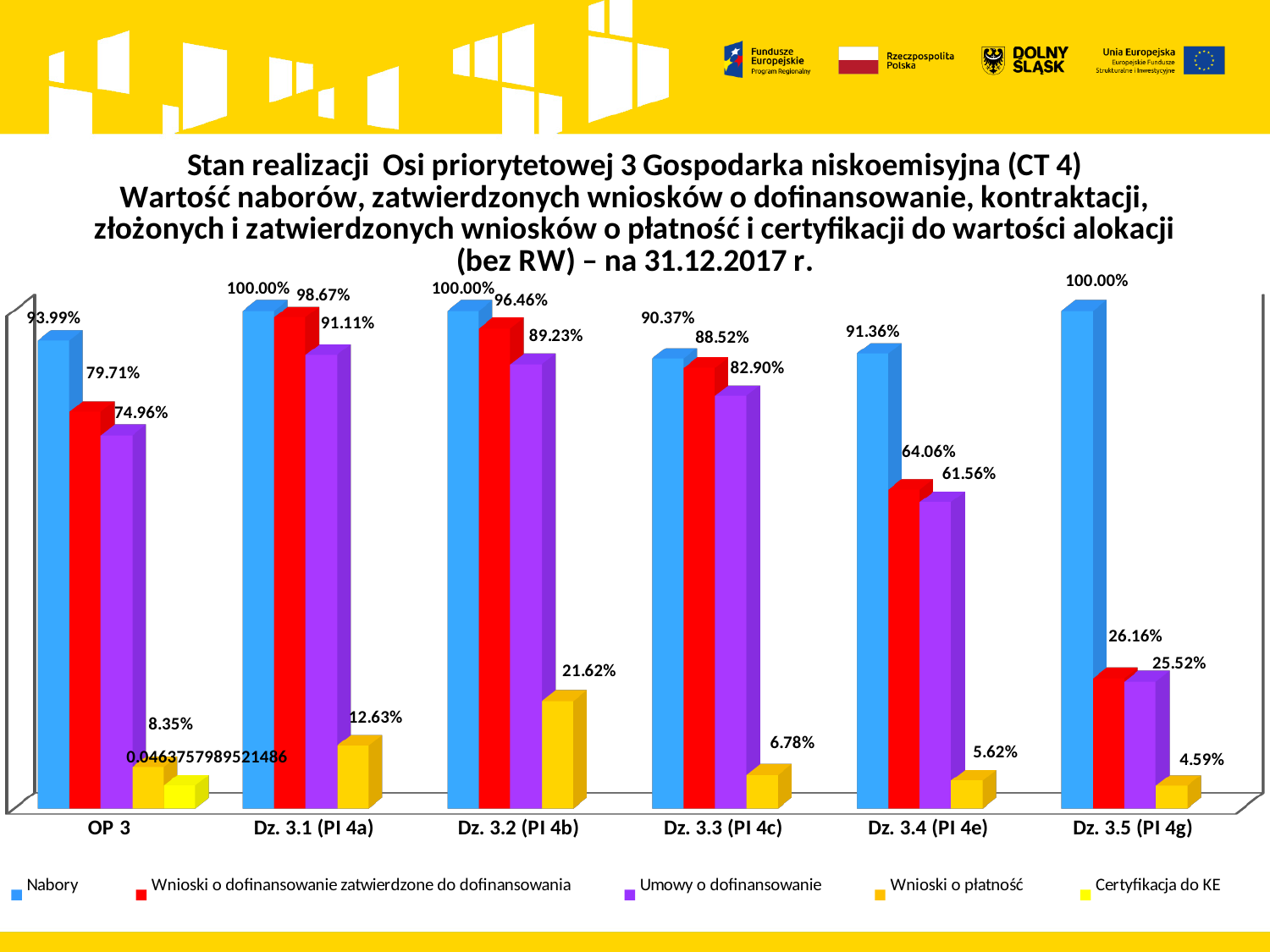
How many categories are shown on the x axis? 6 Which has a higher value for Umowy o dofinansowanie, Dz. 3.1 (PI 4a) or Dz. 3.2 (PI 4b)? Dz. 3.1 (PI 4a) What is the value of Wnioski o płatność for Dz. 3.2 (PI 4b)? 21.62% What is the value of Wnioski o dofinansowanie zatwierdzone do dofinansowania for Dz. 3.5 (PI 4g)? 26.16% What kind of chart is shown on the slide? Bar chart What is the difference between Nabory and Umowy o dofinansowanie for Dz. 3.4 (PI 4e)? 29.80 percentage points Which category has the highest value for Wnioski o płatność? Dz. 3.2 (PI 4b) How many series does the legend list? 5 What is the value of Nabory for Dz. 3.3 (PI 4c)? 90.37% What colour represents Umowy o dofinansowanie in the legend? Purple Which category has the lowest value for Wnioski o płatność? Dz. 3.5 (PI 4g) Which category has the lowest value for Nabory? Dz. 3.3 (PI 4c)